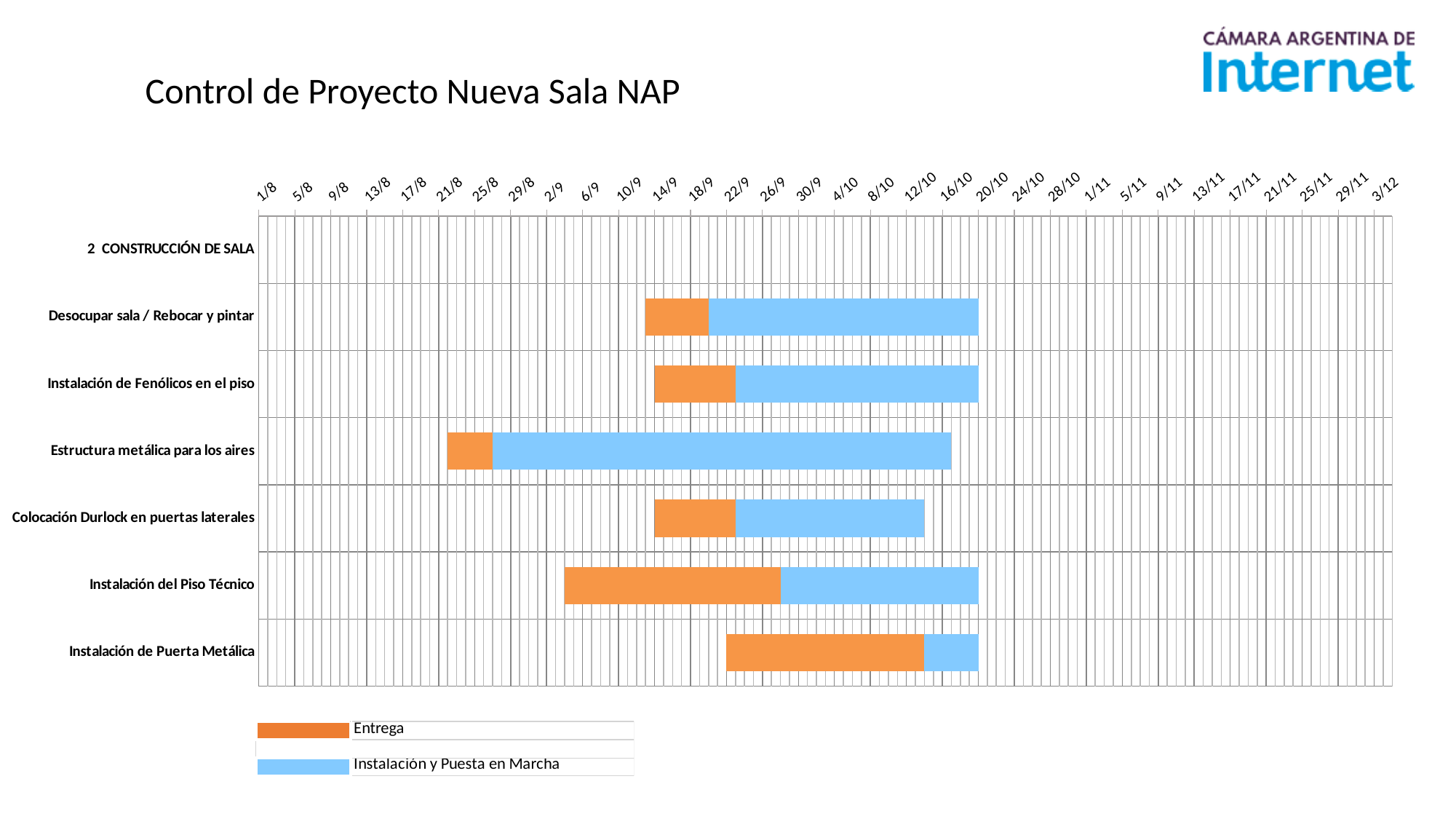
Which task has the longest overall bar? Estructura metálica para los aires How many series does the legend list? 2 Does Instalación de Puerta Metálica start before or after 26/9? before Which task has the shortest Instalación y Puesta en Marcha (blue) segment? Instalación de Puerta Metálica Which starts earlier, Estructura metálica para los aires or Instalación del Piso Técnico? Estructura metálica para los aires Do any of the task bars extend beyond 20/10? No What kind of chart is shown on the slide? bar chart (Gantt chart) What are the two series named in the legend? Entrega; Instalación y Puesta en Marcha What is the title of the slide containing the chart? Control de Proyecto Nueva Sala NAP Which task starts latest on the timeline? Instalación de Puerta Metálica How many tasks have bars plotted on the chart? 6 Which task starts earliest on the timeline? Estructura metálica para los aires